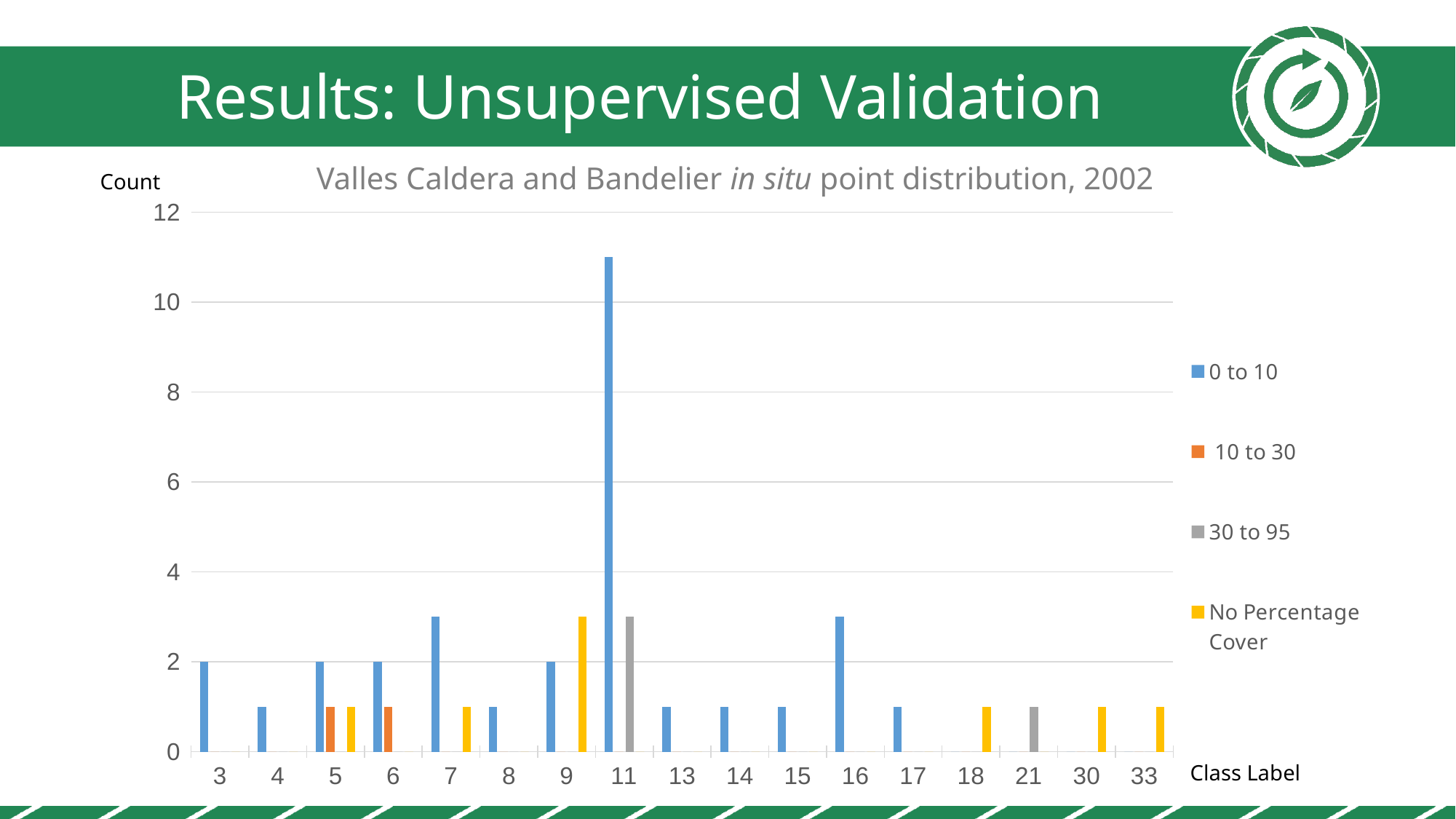
Which class label has the highest count for the 0 to 10 series? 11 How many series does the legend list? 4 What kind of chart is shown on the slide? bar chart Is the count for the 0 to 10 series at class label 4 greater or less than 2? less What is the title of the chart? Valles Caldera and Bandelier in situ point distribution, 2002 Is the count for the 0 to 10 series at class label 16 greater or less than 4? less Which legend entry is shown in grey? 30 to 95 Which is larger for the 0 to 10 series: the count at class label 11 or at class label 16? class label 11 How many class labels are shown on the x axis? 17 Is the count for the 0 to 10 series at class label 11 greater or less than 10? greater What is the count for the 0 to 10 series at class label 9? 2 What is the count for the 0 to 10 series at class label 3? 2